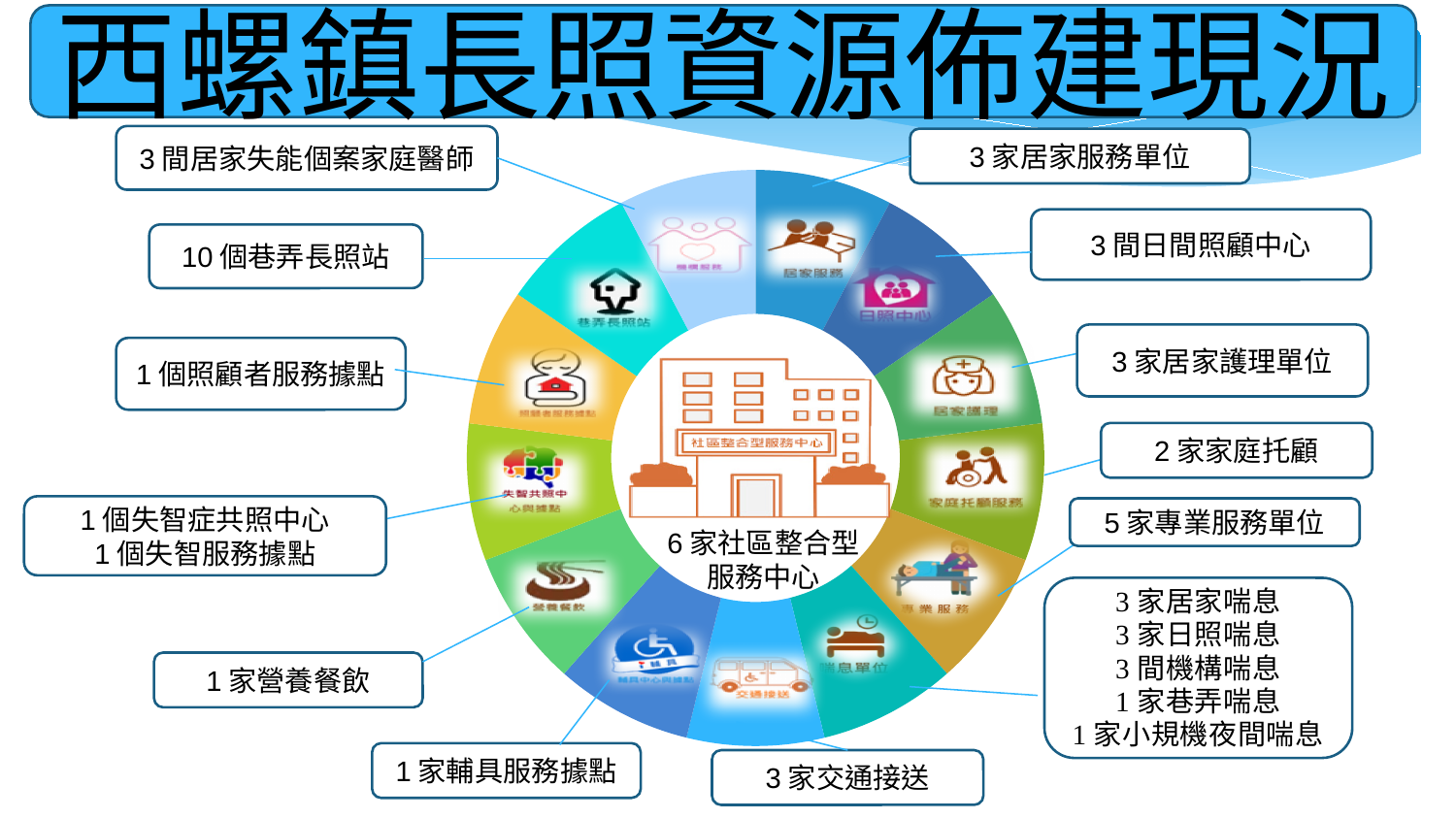
According to the slide, how many 巷弄長照站 are there in 西螺鎮? 10 個 Which resource type has the largest number listed on the slide? 巷弄長照站 (10 個) What is the difference between the number of 巷弄長照站 and the number of 日間照顧中心? 7 What is the title of the slide? 西螺鎮長照資源佈建現況 How many 交通接送 providers are listed on the slide? 3 家 How many 日間照顧中心 does the slide list? 3 間 How many 小規機夜間喘息 providers are listed under the respite services? 1 家 Which is larger: the number of 專業服務單位 or the number of 居家護理單位? 專業服務單位 How many 專業服務單位 are listed on the slide? 5 家 How many 家庭托顧 providers are listed? 2 家 What shape is the diagram used to present the long-term care resources on the slide? A ring (donut) diagram How many 社區整合型服務中心 are shown in the centre of the ring diagram? 6 家